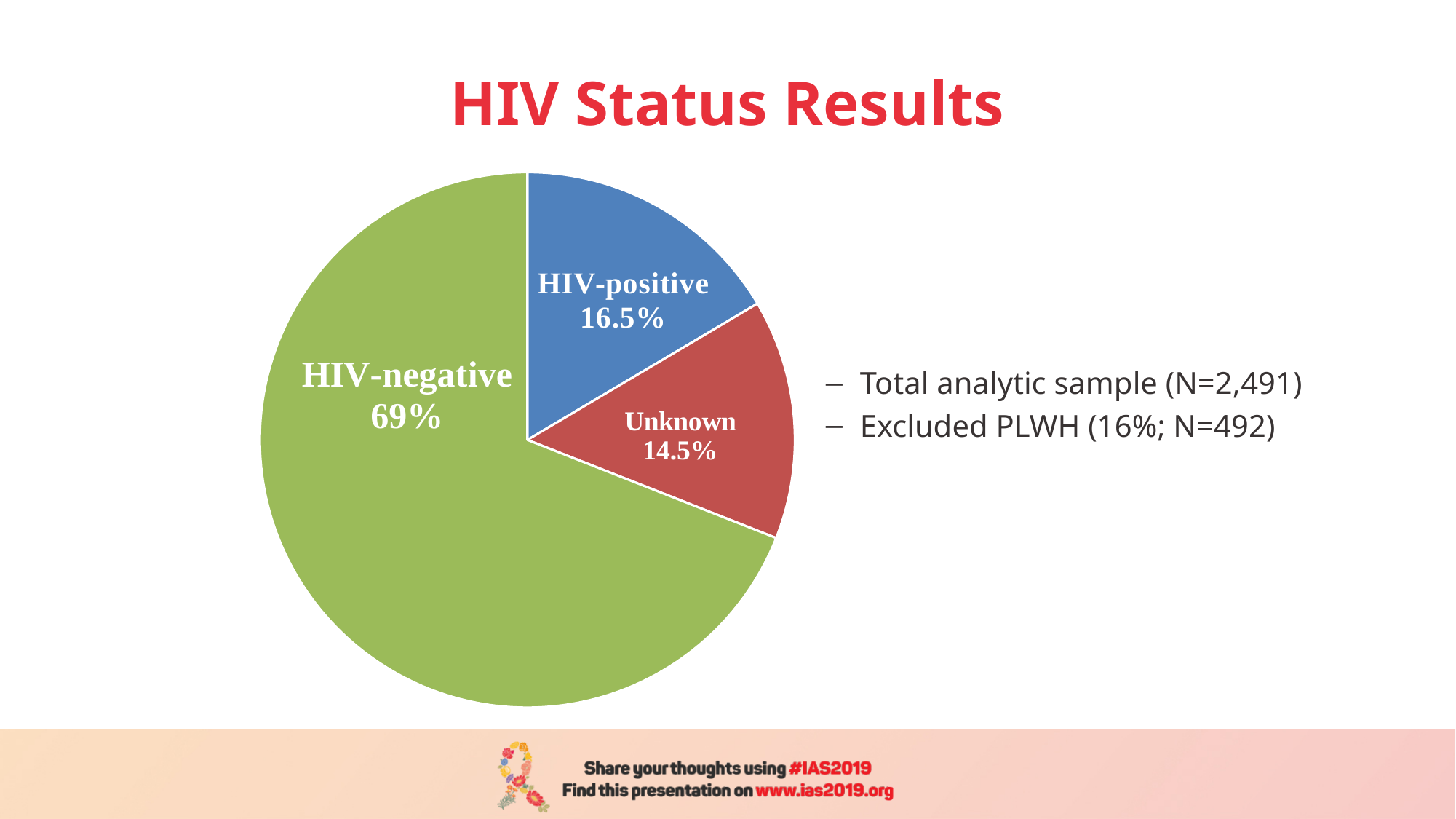
Which slice of the pie is the largest? HIV-negative What percentage of the pie is Unknown? 14.5% What is the difference in percentage points between the HIV-positive and Unknown slices? 2 Which slice of the pie is the smallest? Unknown What type of chart is shown on the slide? Pie chart What colour is the HIV-negative slice of the pie? Green What percentage of the pie is HIV-negative? 69% What percentage of the pie is HIV-positive? 16.5% What is the difference in percentage points between the HIV-negative and HIV-positive slices? 52.5 How many slices does the pie chart have? 3 Which is larger, the HIV-positive slice or the Unknown slice? HIV-positive What is the title of the slide containing the pie chart? HIV Status Results